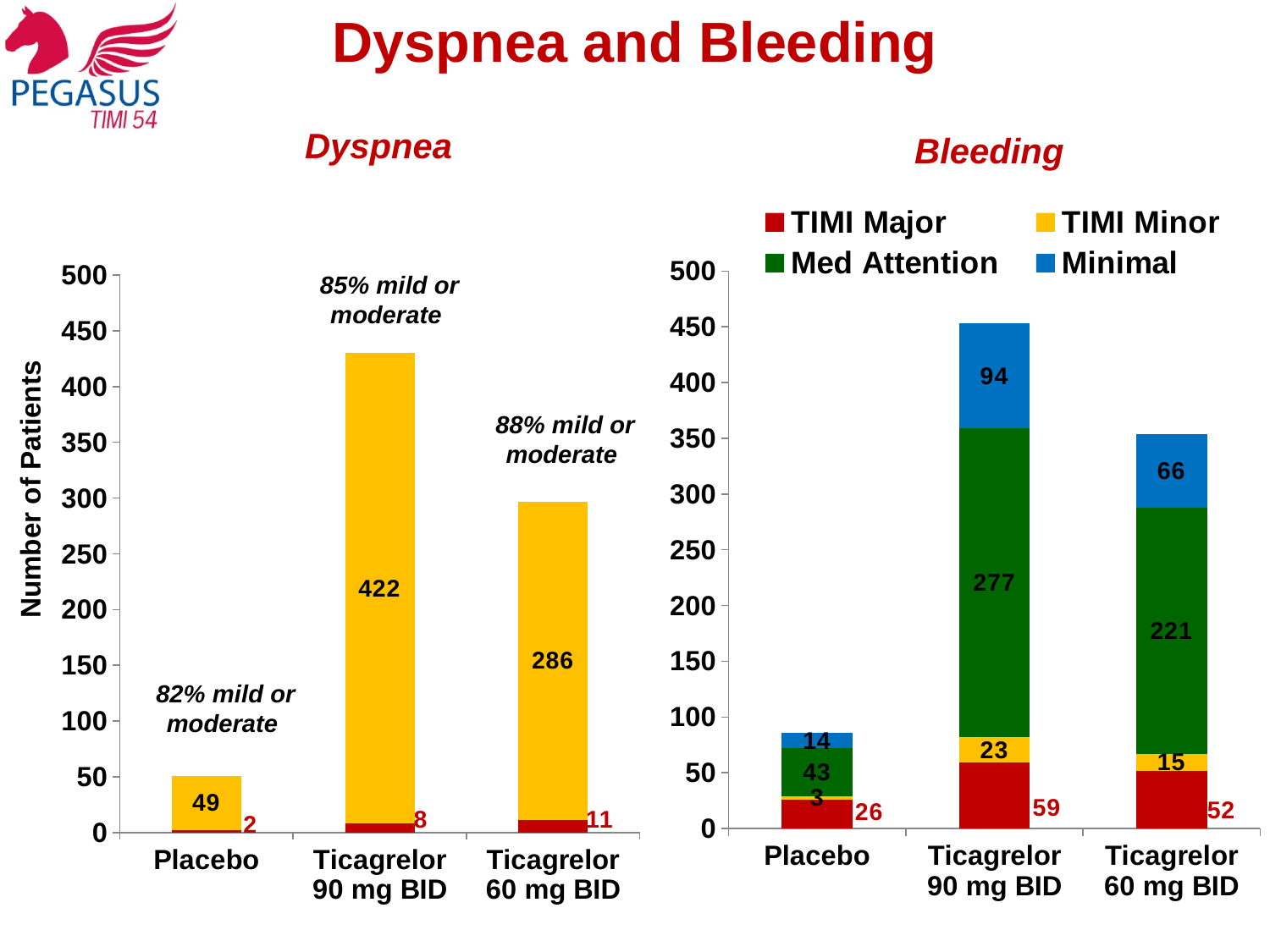
In the Bleeding chart, which is larger: the TIMI Minor value for Ticagrelor 90 mg BID or for Ticagrelor 60 mg BID? Ticagrelor 90 mg BID In the Bleeding chart, what is the Minimal value for Ticagrelor 60 mg BID? 66 In the Bleeding chart, what is the total of the stacked bar for Ticagrelor 90 mg BID? 453 In the Bleeding chart, what is the Med Attention value for Ticagrelor 90 mg BID? 277 In the Dyspnea chart, which treatment group has the lowest yellow-segment value? Placebo How many treatment groups are shown on the x axis of the Dyspnea chart? 3 In the Dyspnea chart, what is the difference between the yellow-segment values for Ticagrelor 90 mg BID and Ticagrelor 60 mg BID? 136 In the Dyspnea chart, what is the value of the yellow segment for Ticagrelor 90 mg BID? 422 In the Bleeding chart, what is the TIMI Major value for Placebo? 26 What type of chart is the Bleeding chart? Stacked bar chart How many series does the legend of the Bleeding chart list? 4 In the Bleeding chart, what is the total of the stacked bar for Placebo? 86